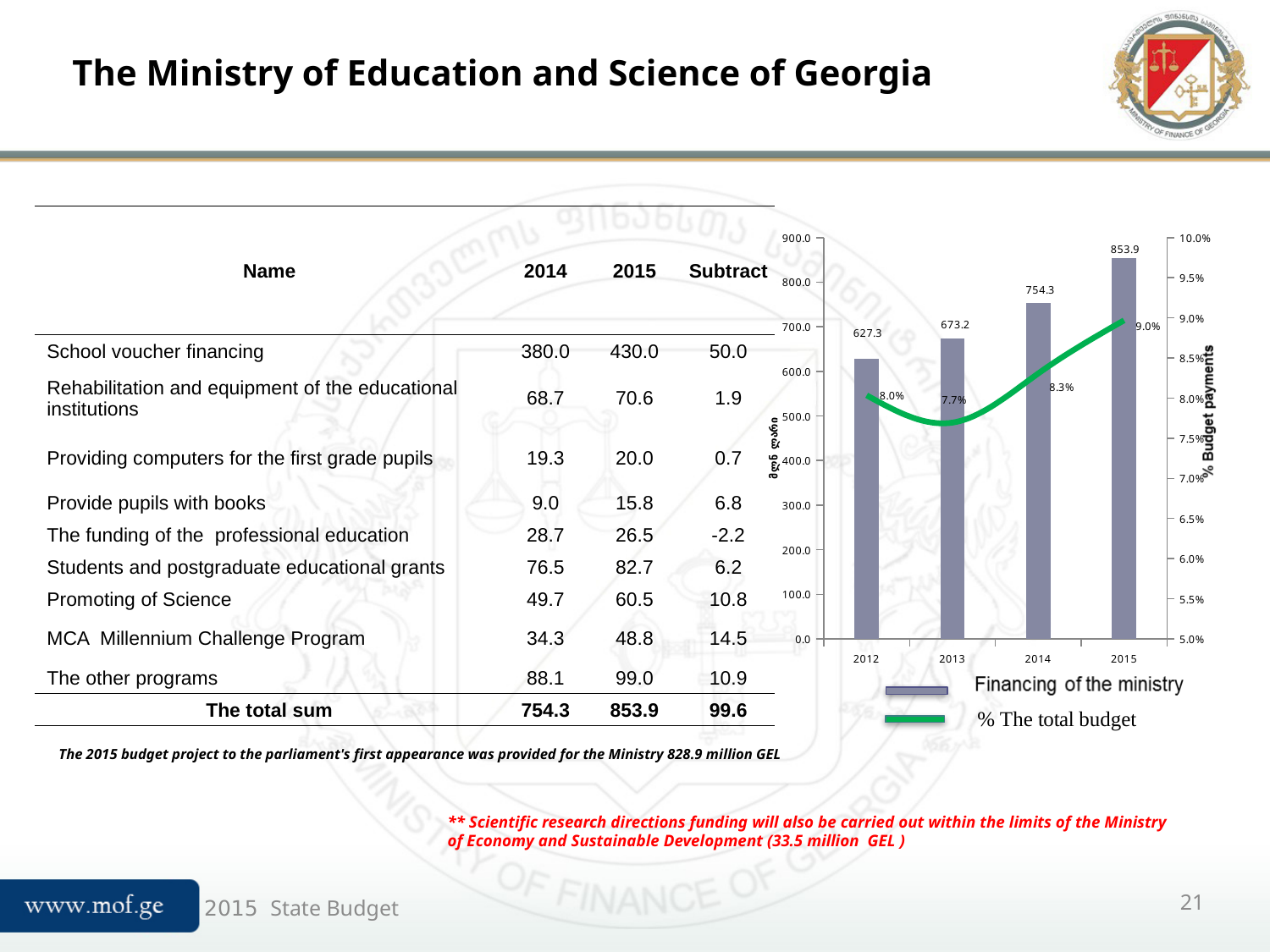
What is the difference in Financing of the ministry between 2015 and 2014? 99.6 What is the % The total budget value for 2015? 9.0% How many series does the chart legend list? 2 Which series is drawn as a green line in the chart? % The total budget What is the % The total budget value for 2013? 7.7% What is the value of Financing of the ministry for 2012? 627.3 Which year has the lowest % The total budget value? 2013 Does the Financing of the ministry rise or fall from 2012 to 2015? rise Which is larger, the Financing of the ministry in 2013 or in 2014? 2014 How many years are shown on the x axis of the chart? 4 What is the value of Financing of the ministry for 2015? 853.9 Which year has the highest Financing of the ministry? 2015